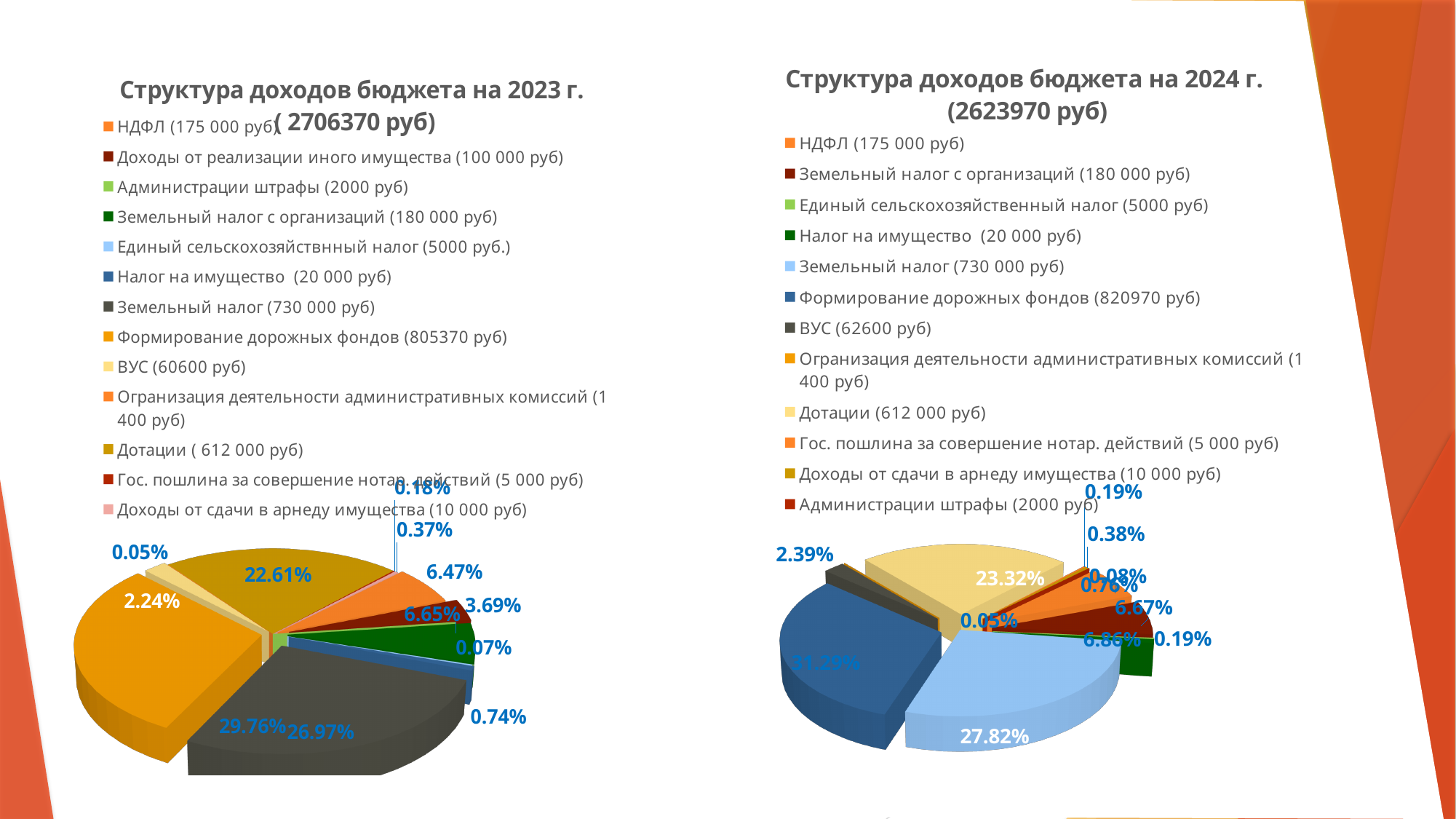
How many entries does the legend of the chart 'Структура доходов бюджета на 2023 г.' list? 13 What is the difference between the largest slice in the 2024 chart (31.29%) and the largest slice in the 2023 chart (29.76%)? 1.53% In the chart 'Структура доходов бюджета на 2023 г.', what is the smallest percentage shown on a slice? 0.05% How many entries does the legend of the chart 'Структура доходов бюджета на 2024 г.' list? 12 In the chart 'Структура доходов бюджета на 2024 г.', what share does the slice for 'Земельный налог (730 000 руб)' have? 27.82% In the chart 'Структура доходов бюджета на 2024 г.', what is the largest percentage shown on a slice? 31.29% What kind of chart is used on the left side of the slide for 'Структура доходов бюджета на 2023 г.'? Pie chart In the chart 'Структура доходов бюджета на 2024 г.', what is the smallest percentage shown on a slice? 0.05% In the chart 'Структура доходов бюджета на 2023 г.', what is the largest percentage shown on a slice? 29.76% What total budget amount is given in the title of the chart on the right side of the slide? 2623970 руб Which is larger: the largest slice in the 2023 chart (29.76%) or the largest slice in the 2024 chart (31.29%)? The 2024 chart's largest slice (31.29%) In the chart 'Структура доходов бюджета на 2024 г.', what share does the slice for 'Формирование дорожных фондов (820970 руб)' have? 31.29%